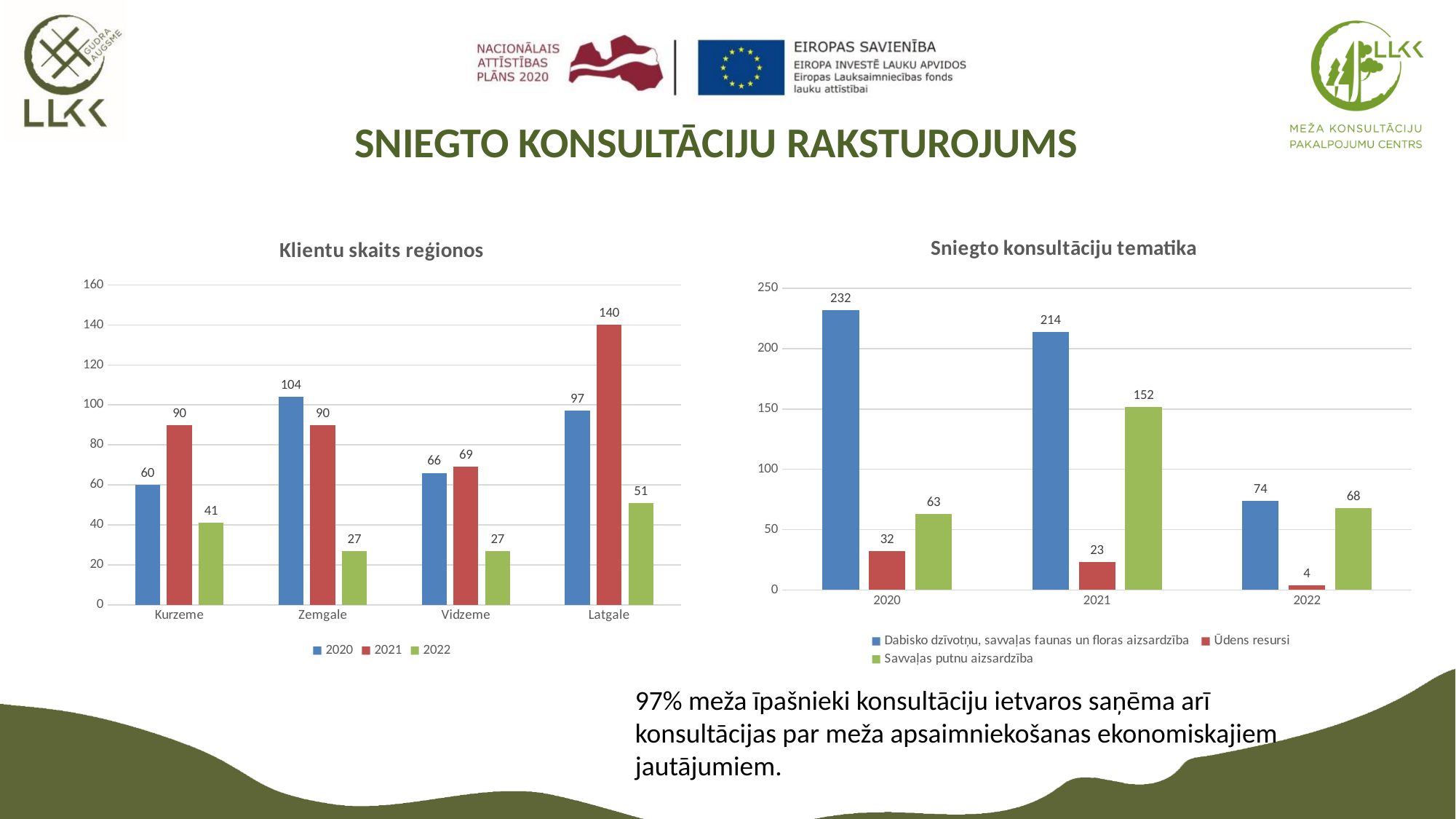
In the 'Klientu skaits reģionos' chart, what is the value for Latgale in 2021? 140 In the 'Sniegto konsultāciju tematika' chart, which is larger in 2022: 'Dabisko dzīvotņu, savvaļas faunas un floras aizsardzība' or 'Ūdens resursi'? Dabisko dzīvotņu, savvaļas faunas un floras aizsardzība In the 'Sniegto konsultāciju tematika' chart, which year has the highest value for 'Dabisko dzīvotņu, savvaļas faunas un floras aizsardzība'? 2020 In the 'Klientu skaits reģionos' chart, which region has the lowest value for 2022? Zemgale and Vidzeme (both 27) In the 'Klientu skaits reģionos' chart, how many regions are shown on the x axis? 4 In the 'Sniegto konsultāciju tematika' chart, what is the difference between the 2020 and 2021 values for 'Dabisko dzīvotņu, savvaļas faunas un floras aizsardzība'? 18 In the 'Sniegto konsultāciju tematika' chart, what is the value for 'Ūdens resursi' in 2022? 4 In the 'Sniegto konsultāciju tematika' chart, what is the value for 'Savvaļas putnu aizsardzība' in 2021? 152 What kind of chart is 'Sniegto konsultāciju tematika'? Bar chart In the 'Klientu skaits reģionos' chart, how many series does the legend list? 3 In the 'Klientu skaits reģionos' chart, what is the value for Zemgale in 2020? 104 In the 'Klientu skaits reģionos' chart, what is the difference between the 2021 and 2022 values for Latgale? 89